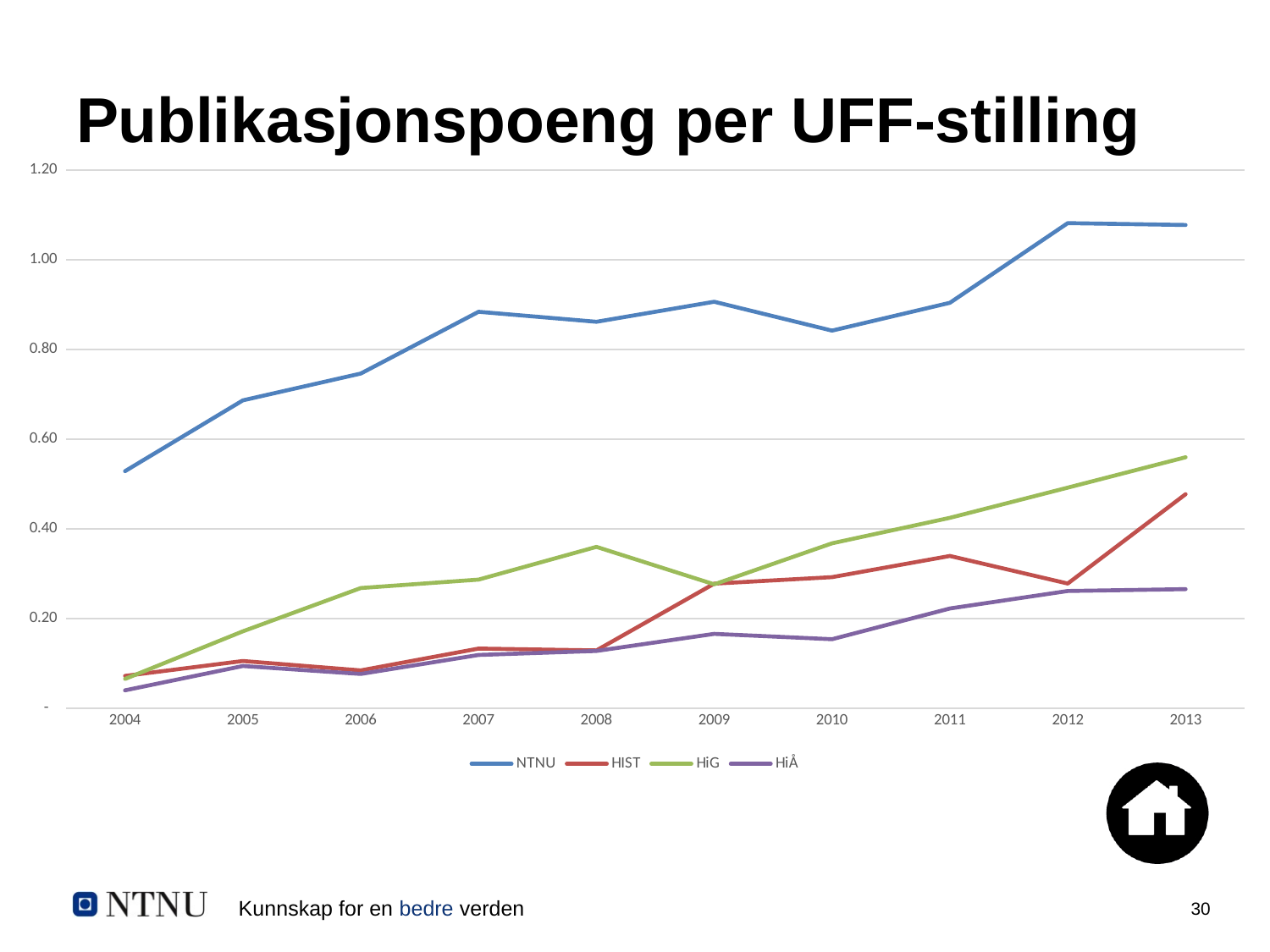
How many years are shown on the x axis? 10 What is the title of the chart? Publikasjonspoeng per UFF-stilling Which series has the lowest value in 2013? HiÅ Is the value for HIST in 2012 greater or less than 0.40? less Is the value for NTNU in 2012 greater or less than 1.00? greater In 2013, which is larger: the value for HiG or the value for HIST? HiG How many series does the legend list? 4 Which series has the highest value in 2013? NTNU What kind of chart is shown on the slide? line chart Is the value for HiG in 2013 greater or less than 0.40? greater Does the NTNU line generally rise or fall from 2004 to 2013? rise